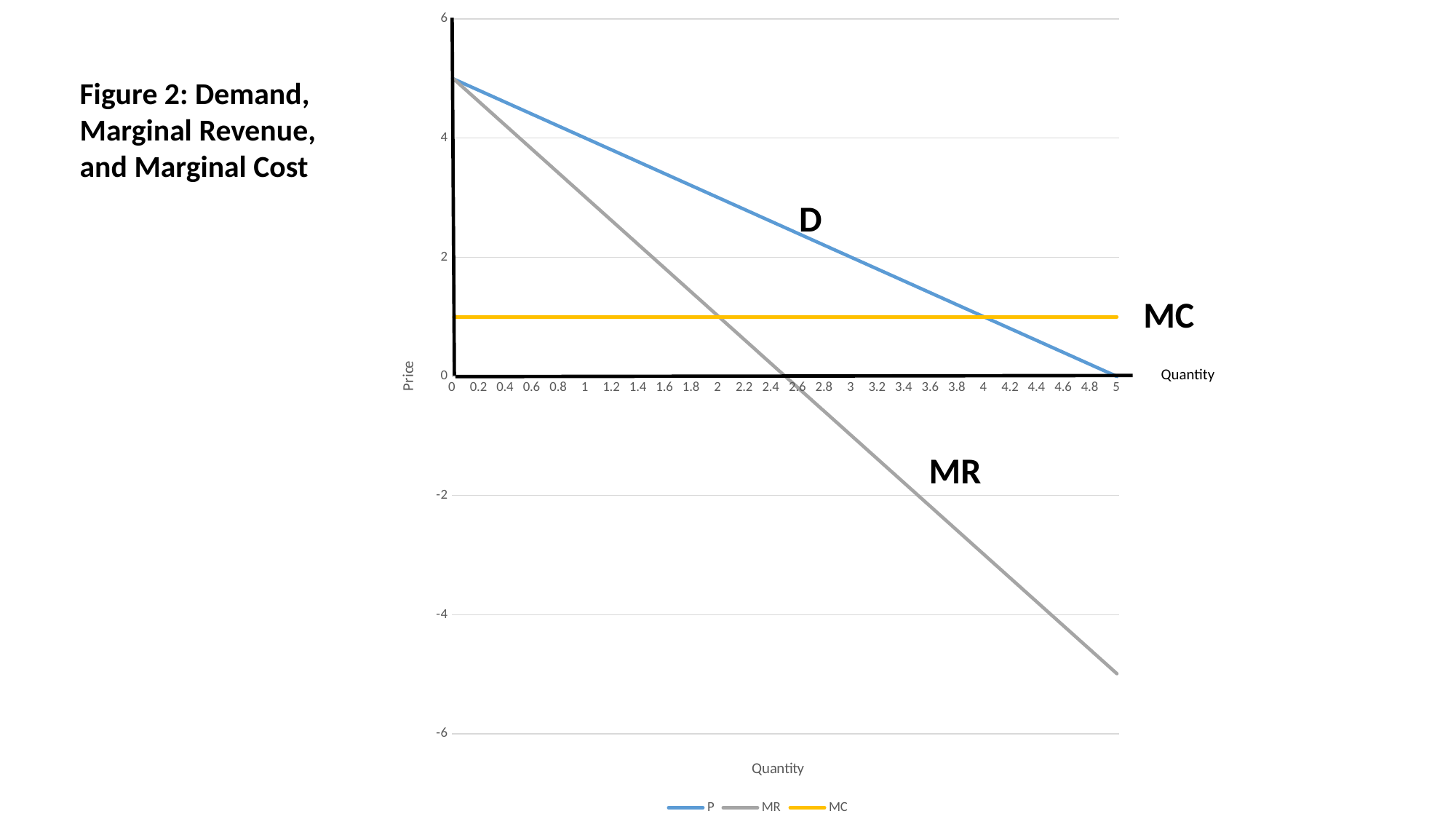
What are the series names listed in the legend? P, MR, MC Is the value of the MR line at quantity 4 greater or less than -2? less What kind of chart is shown on the slide? line chart Is the value of the MC line greater or less than 2? less Is the value of the D line at quantity 0 greater or less than 4? greater What is the title of the figure on the slide? Figure 2: Demand, Marginal Revenue, and Marginal Cost What is the value of the D (P) line at quantity 5? 0 At quantity 3, which line has the higher value, D or MR? D Does the MR line rise or fall as quantity increases? fall How many series does the legend list? 3